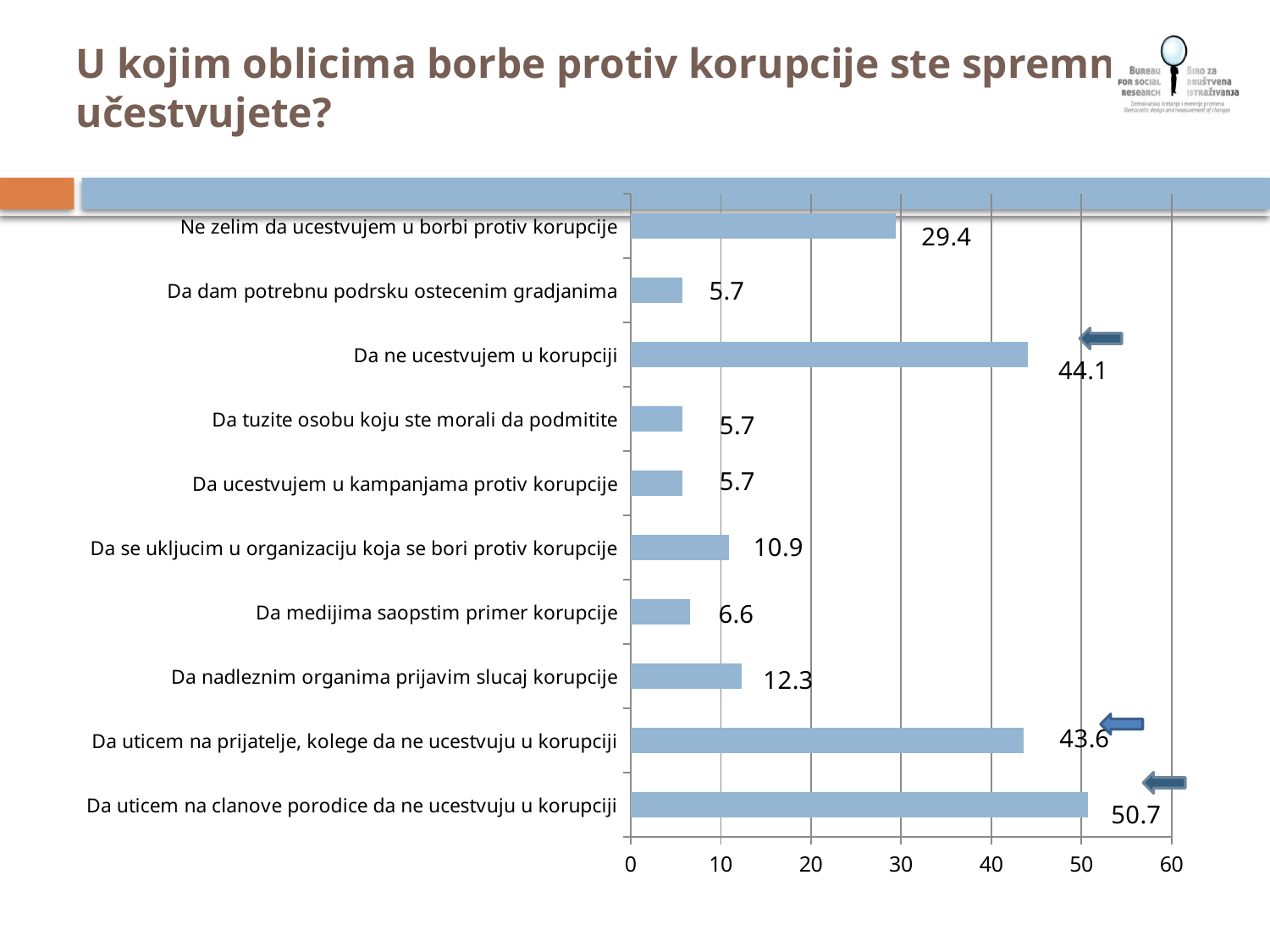
What is the difference between the values for "Da uticem na clanove porodice da ne ucestvuju u korupciji" and "Ne zelim da ucestvujem u borbi protiv korupcije"? 21.3 What is the difference between the values for "Da nadleznim organima prijavim slucaj korupcije" and "Da medijima saopstim primer korupcije"? 5.7 How many categories are shown on the chart? 10 What is the value for "Da se ukljucim u organizaciju koja se bori protiv korupcije"? 10.9 What is the value for "Da medijima saopstim primer korupcije"? 6.6 What kind of chart is shown on the slide? bar chart What is the lowest value shown on the chart? 5.7 Which category has the highest value? Da uticem na clanove porodice da ne ucestvuju u korupciji What is the value for "Da uticem na clanove porodice da ne ucestvuju u korupciji"? 50.7 Is the value for "Da nadleznim organima prijavim slucaj korupcije" greater or less than 10? greater What is the value for "Ne zelim da ucestvujem u borbi protiv korupcije"? 29.4 Which is larger: the value for "Da ne ucestvujem u korupciji" or the value for "Ne zelim da ucestvujem u borbi protiv korupcije"? Da ne ucestvujem u korupciji